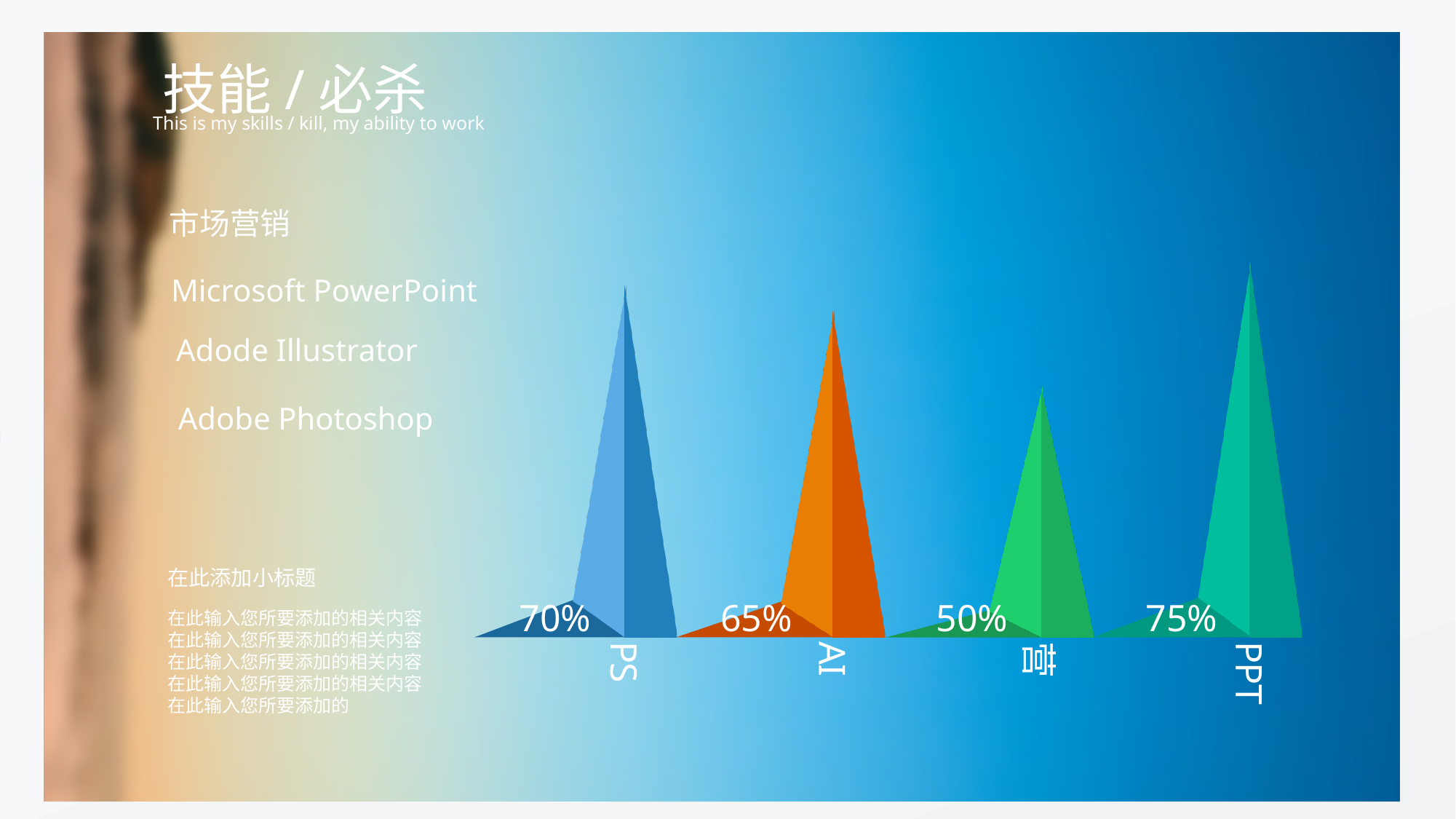
Which is larger, the value for PS or the value for AI? PS What colour is the shape for AI? Orange What is the value shown for AI? 65% What is the value shown for PS? 70% What is the value shown for PPT? 75% How many categories are shown in the chart? 4 What is the difference between the values for PPT and PS? 5% Which category has the highest value? PPT Which category has the lowest value? 营